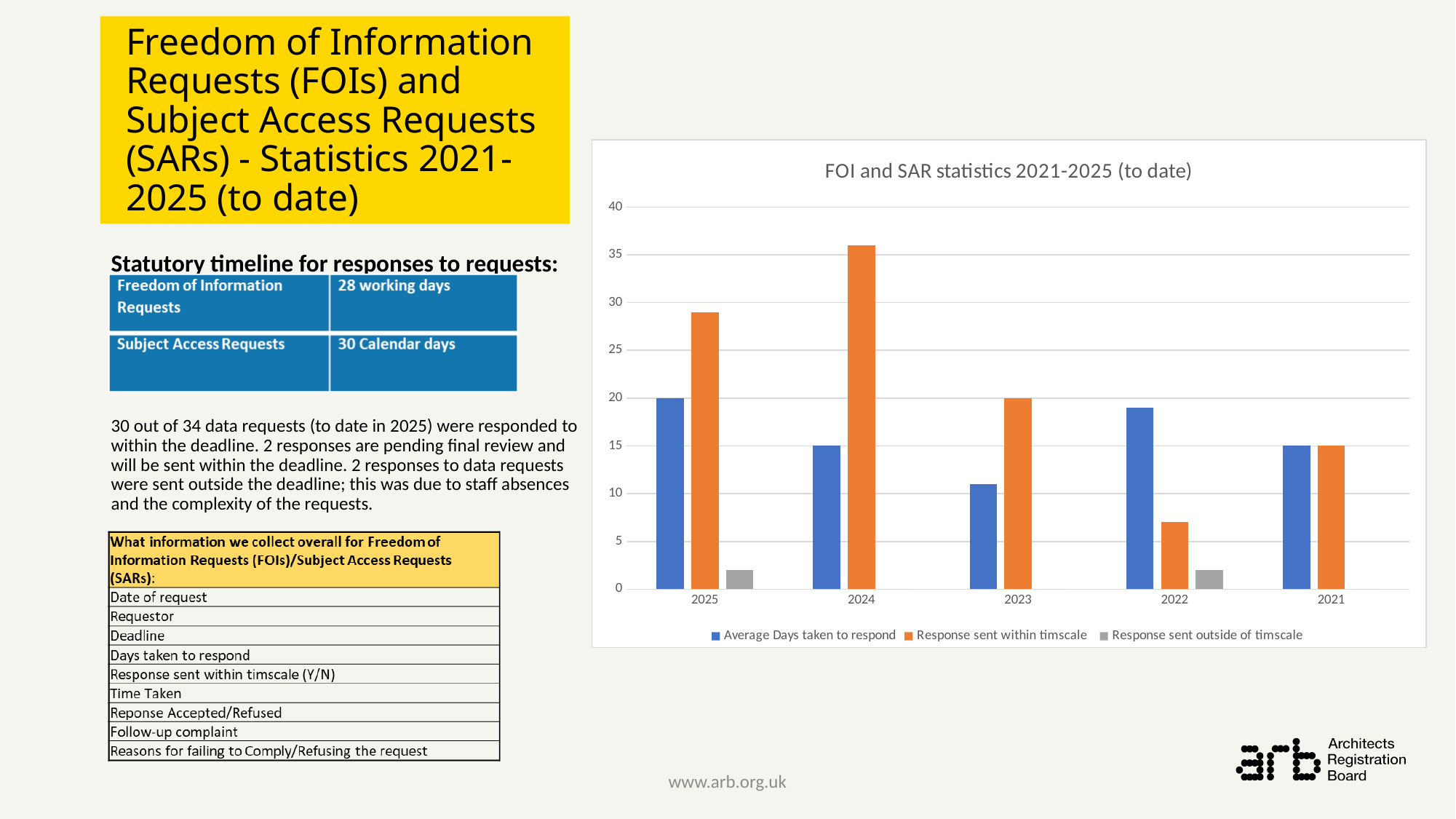
Is the value for Response sent within timscale in 2024 greater or less than 35? greater Which year has the highest value for Response sent within timscale? 2024 What is the value of Average Days taken to respond for 2024? 15 Which year has the lowest value for Response sent within timscale? 2022 How many years are shown on the x axis of the chart? 5 What is the value of Response sent within timscale for 2021? 15 What is the value of Response sent within timscale for 2023? 20 Which is larger in 2025: Average Days taken to respond or Response sent within timscale? Response sent within timscale What is the value of Average Days taken to respond for 2025? 20 How many series does the chart legend list? 3 Is the value for Response sent within timscale in 2022 greater or less than 10? less What type of chart is shown on the slide? bar chart